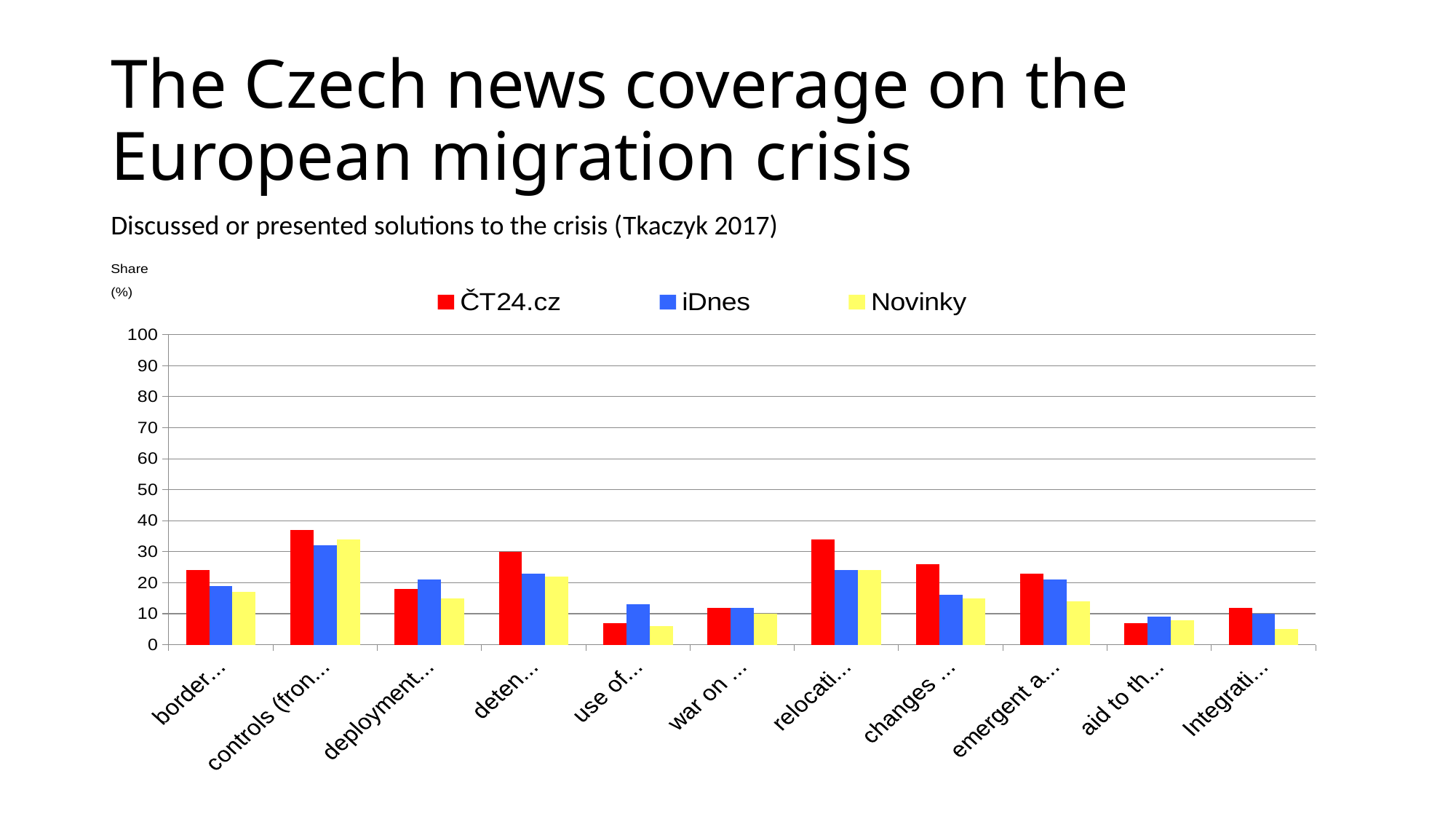
For the category "deployment…", which series has the larger value, ČT24.cz or iDnes? iDnes Is the iDnes value for "relocati…" greater or less than 20? greater Which series is shown in red in the chart? ČT24.cz How many categories are shown along the x axis of the chart? 11 For the category "emergent a…", which series has the larger value, ČT24.cz or Novinky? ČT24.cz How many series does the chart legend list? 3 Is the ČT24.cz value for "border…" greater or less than 20? greater Is the ČT24.cz value for "controls (fron…" greater or less than 30? greater What kind of chart is shown on the slide? bar chart What label is given to the vertical axis of the chart? Share (%) For the category "use of…", which series has the larger value, ČT24.cz or iDnes? iDnes